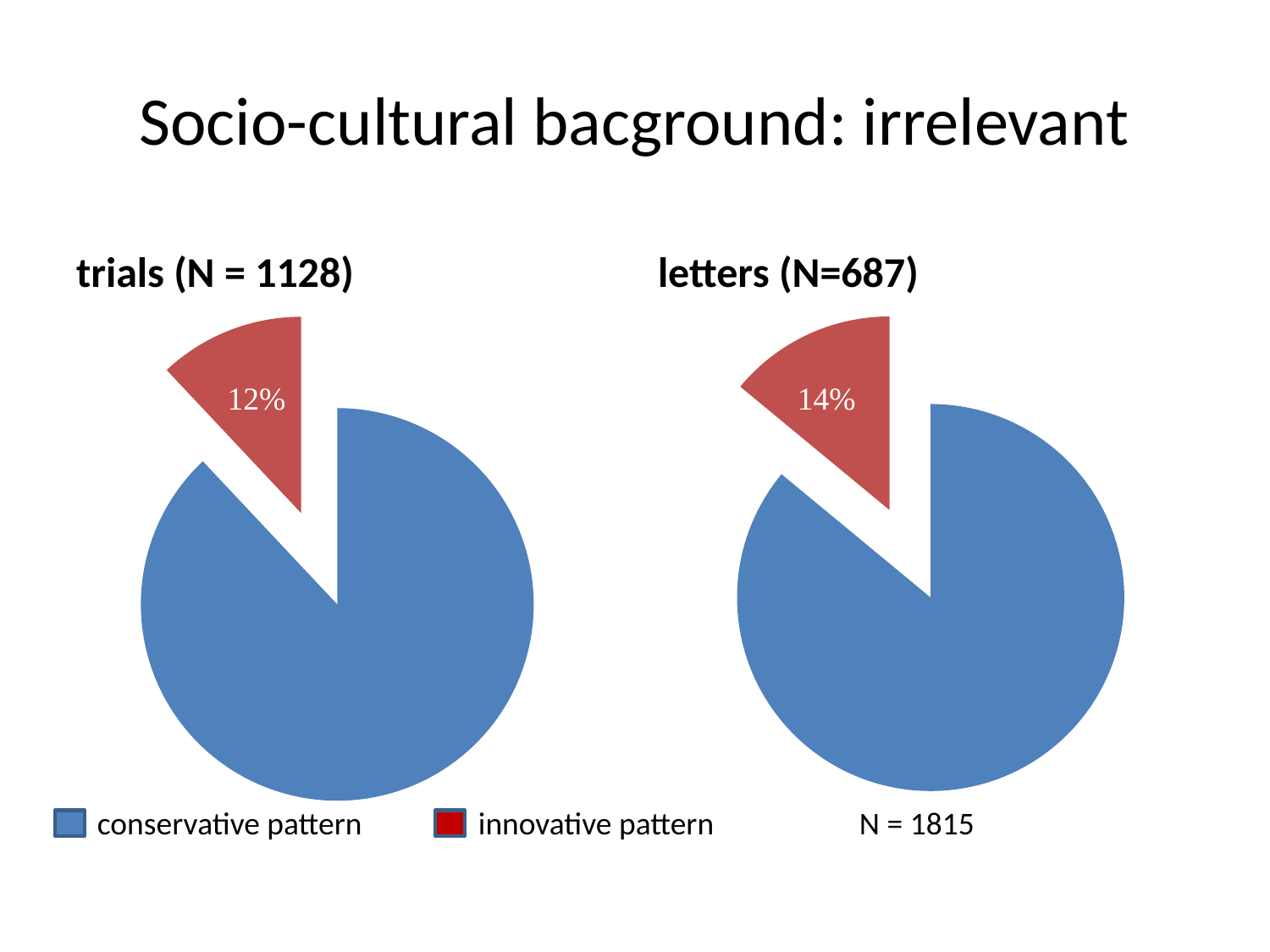
What is the title of the slide containing the two pie charts? Socio-cultural bacground: irrelevant In the letters (N=687) pie chart, which pattern has the smallest slice? innovative pattern By how many percentage points does the innovative pattern share in the letters (N=687) chart exceed that in the trials (N = 1128) chart? 2 percentage points In the trials (N = 1128) pie chart, is the innovative pattern slice greater or less than 50%? less What kind of chart is used for the trials (N = 1128) data? Pie chart In the trials (N = 1128) pie chart, what share is labelled for the innovative pattern slice? 12% How many slices does the letters (N=687) pie chart have? 2 Which chart shows a larger share for the innovative pattern, trials (N = 1128) or letters (N=687)? letters (N=687) Which colour represents the innovative pattern in the legend? Red In the letters (N=687) pie chart, what share is labelled for the innovative pattern slice? 14% How many entries does the shared legend list? 2 In the trials (N = 1128) pie chart, which pattern has the largest slice? conservative pattern